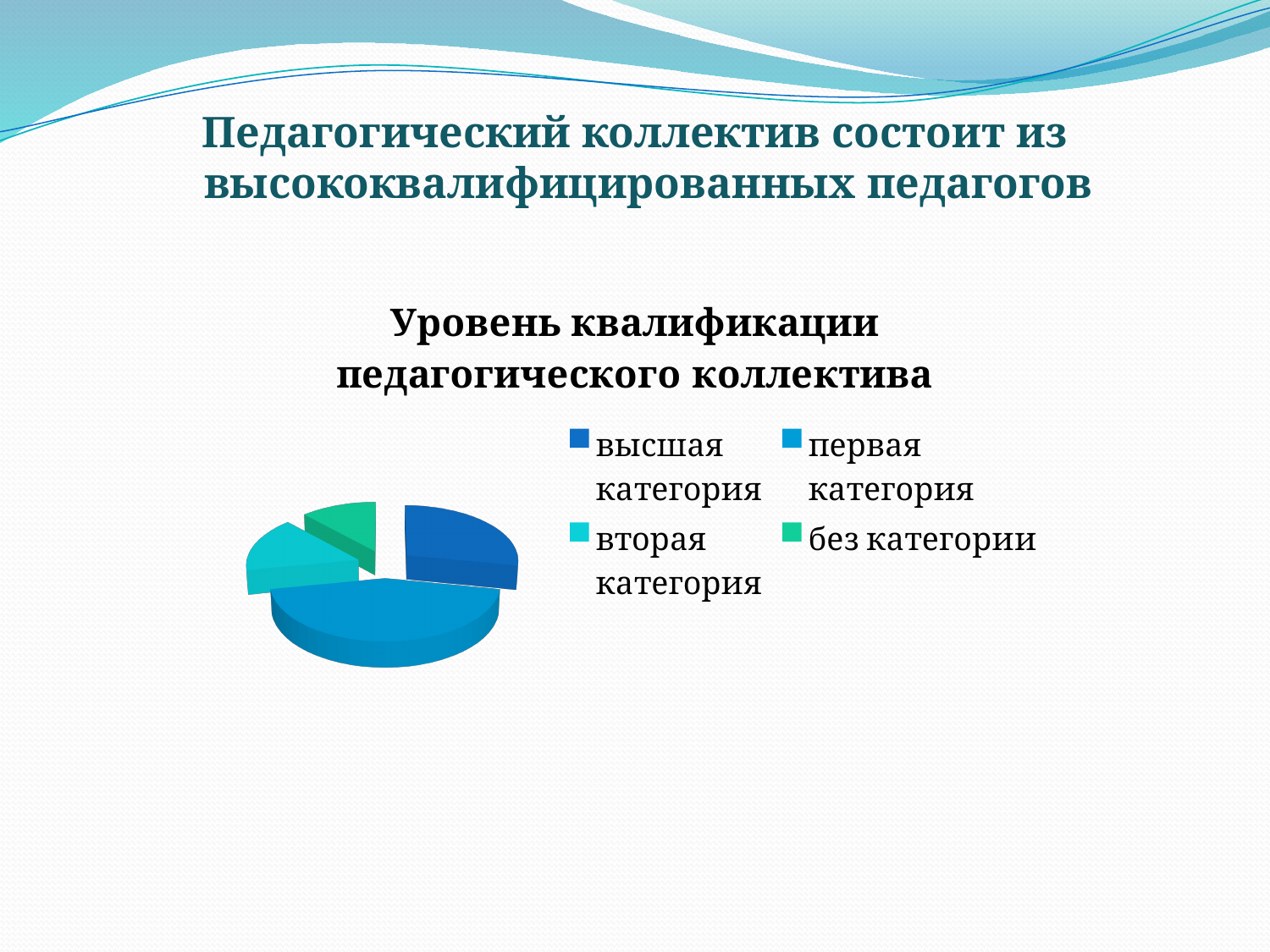
Which slice is larger: первая категория or высшая категория? первая категория Which category has the smallest slice of the pie? без категории Which slice is larger: вторая категория or без категории? вторая категория Which category has the largest slice of the pie? первая категория What is the title of the chart? Уровень квалификации педагогического коллектива How many categories does the pie chart have? 4 How many entries does the legend list? 4 Which legend entry is shown in green? без категории Which slice is larger: высшая категория or без категории? высшая категория What kind of chart is shown on the slide? pie chart